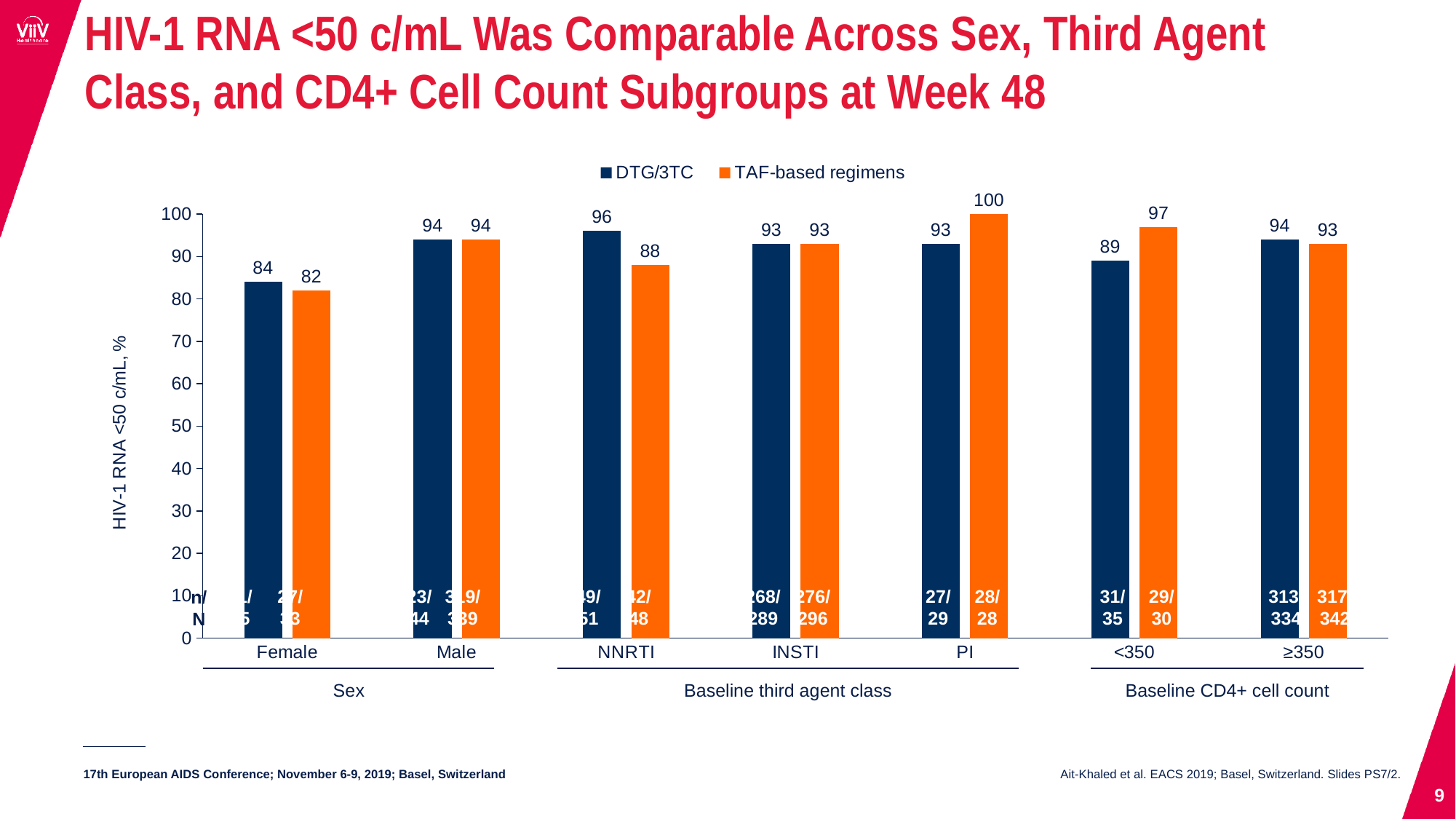
How many subgroup categories are shown on the x axis? 7 Which subgroup has the highest TAF-based regimens value? PI What is the TAF-based regimens value for the PI subgroup? 100 For the <350 subgroup, which series has the larger value, DTG/3TC or TAF-based regimens? TAF-based regimens What is the DTG/3TC value for the <350 CD4+ cell count subgroup? 89 Which subgroup has the lowest DTG/3TC value? Female How many series does the legend list? 2 What is the difference between the DTG/3TC and TAF-based regimens values for the NNRTI subgroup? 8 What is the y-axis label of the chart? HIV-1 RNA <50 c/mL, % What is the TAF-based regimens value for the NNRTI subgroup? 88 What kind of chart is shown on the slide? Bar chart What is the DTG/3TC value for the Female subgroup? 84